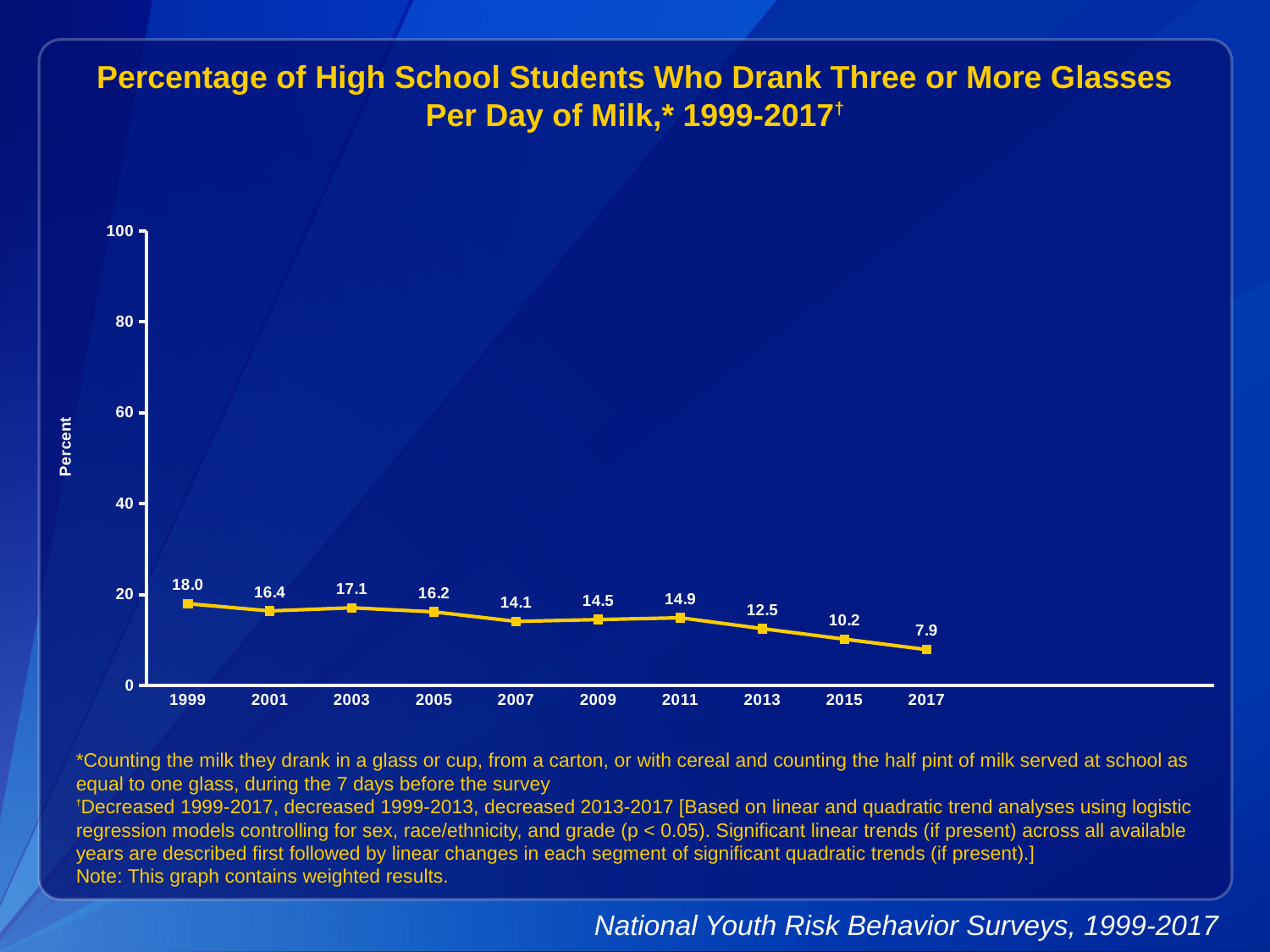
Do the values generally rise or fall from 1999 to 2017? fall Which year has the lowest value on the chart? 2017 What is the value plotted for 2009? 14.5 What kind of chart is shown on the slide? line chart Is the value for 2013 greater or less than 20? less Which year has the larger value, 2003 or 2005? 2003 What percentage of high school students drank three or more glasses of milk per day in 1999? 18.0 What is the value plotted for 2017? 7.9 How many years are plotted on the chart? 10 What is the difference between the values for 1999 and 2017? 10.1 Which year has the highest value on the chart? 1999 What is the label on the y axis? Percent